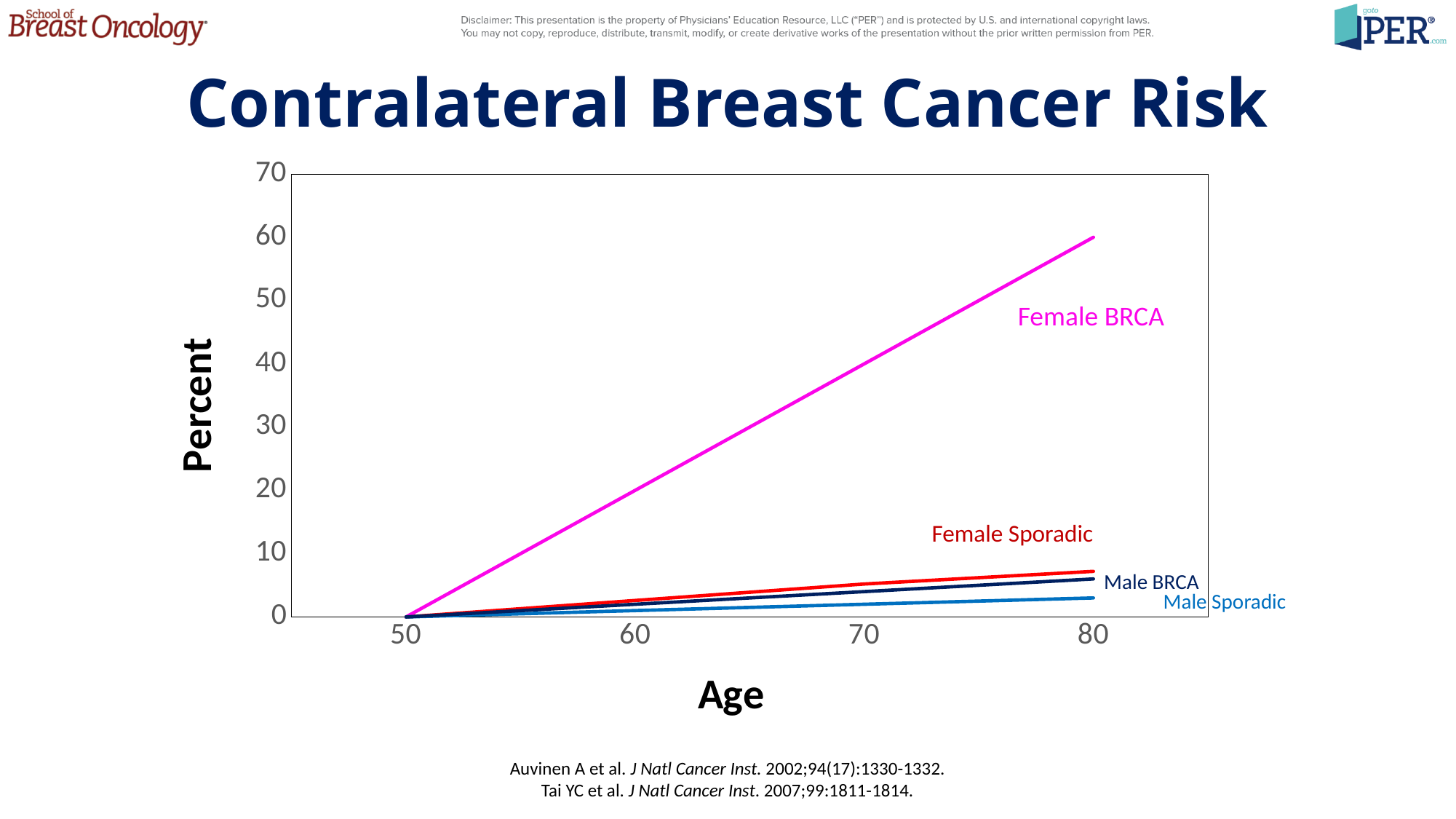
Is the value for Female BRCA at age 80 greater or less than 70? less How many series are labelled on the chart? 4 What kind of chart is shown on the slide? line chart Do the values for Female BRCA rise or fall as age increases from 50 to 80? rise Which series has the highest value at age 80? Female BRCA Which is larger at age 80, Female BRCA or Female Sporadic? Female BRCA Is the value for Female BRCA at age 70 greater or less than 30? greater What is the label of the y axis? Percent Which is larger at age 80, Male BRCA or Male Sporadic? Male BRCA Is the value for Female BRCA at age 80 greater or less than 50? greater Which series has the lowest value at age 80? Male Sporadic